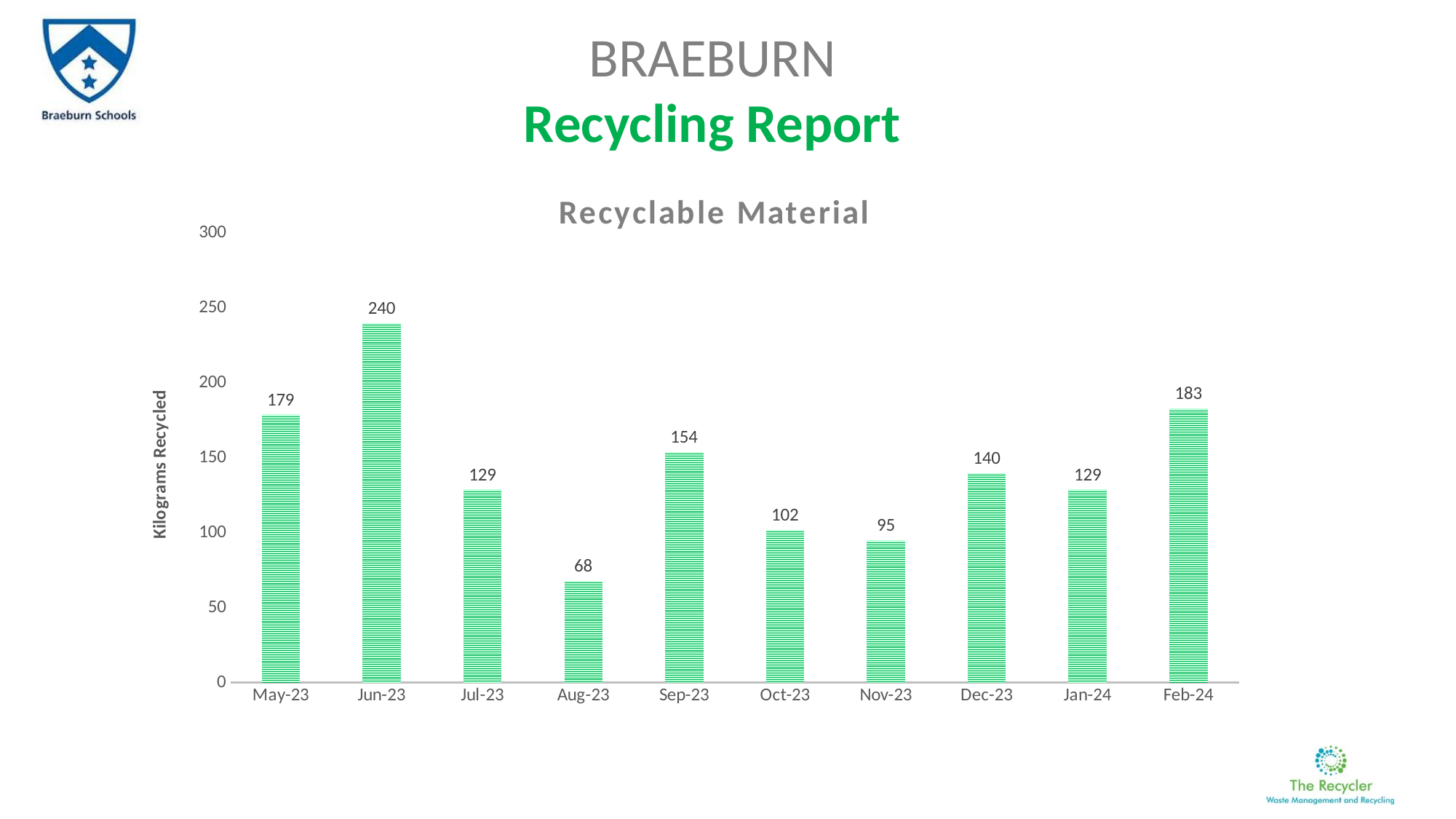
What is the difference between the values for Jun-23 and May-23? 61 What is the label of the vertical axis in the Recyclable Material chart? Kilograms Recycled What is the value for Jun-23 in the Recyclable Material chart? 240 Which month has the lowest value in the Recyclable Material chart? Aug-23 What is the value shown for Feb-24? 183 How many months are shown on the x axis of the Recyclable Material chart? 10 Which month has the highest value in the Recyclable Material chart? Jun-23 What is the difference between the values for Feb-24 and Jan-24? 54 Which is larger, the value for Sep-23 or the value for Dec-23? Sep-23 Is the value for Nov-23 greater or less than 100? less What kind of chart is the Recyclable Material chart? bar chart How many kilograms were recycled in Aug-23? 68